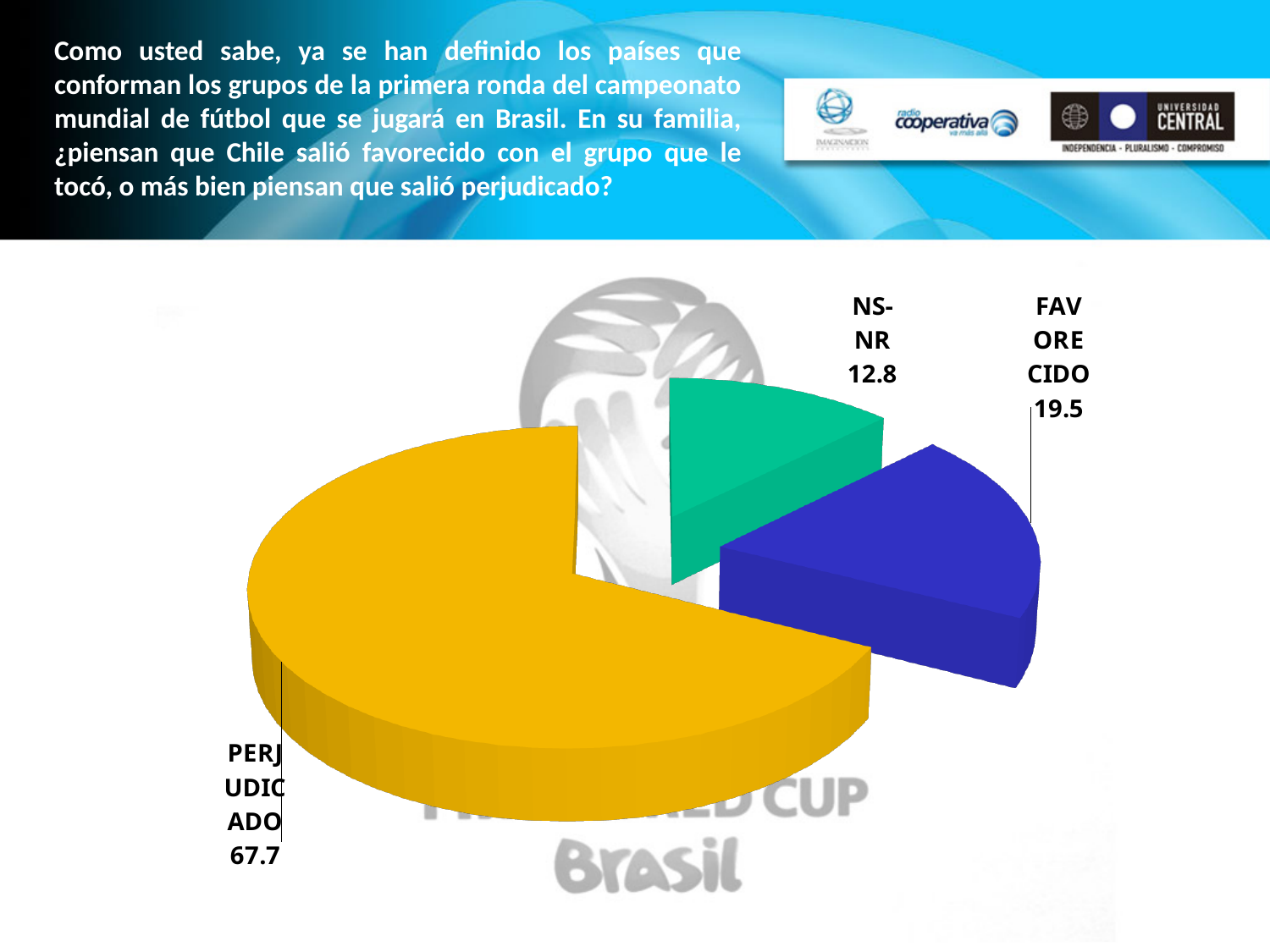
What is the value for PERJUDICADO? 67.7 Which category has the smallest slice of the pie? NS-NR What colour is the FAVORECIDO slice? Blue What is the value for FAVORECIDO? 19.5 Which is larger, the value for FAVORECIDO or the value for NS-NR? FAVORECIDO What colour is the PERJUDICADO slice? Yellow How many slices does the pie chart have? 3 What is the difference between the values for FAVORECIDO and NS-NR? 6.7 What is the value for NS-NR? 12.8 What is the difference between the values for PERJUDICADO and FAVORECIDO? 48.2 Which category has the largest slice of the pie? PERJUDICADO What kind of chart is shown on the slide? Pie chart